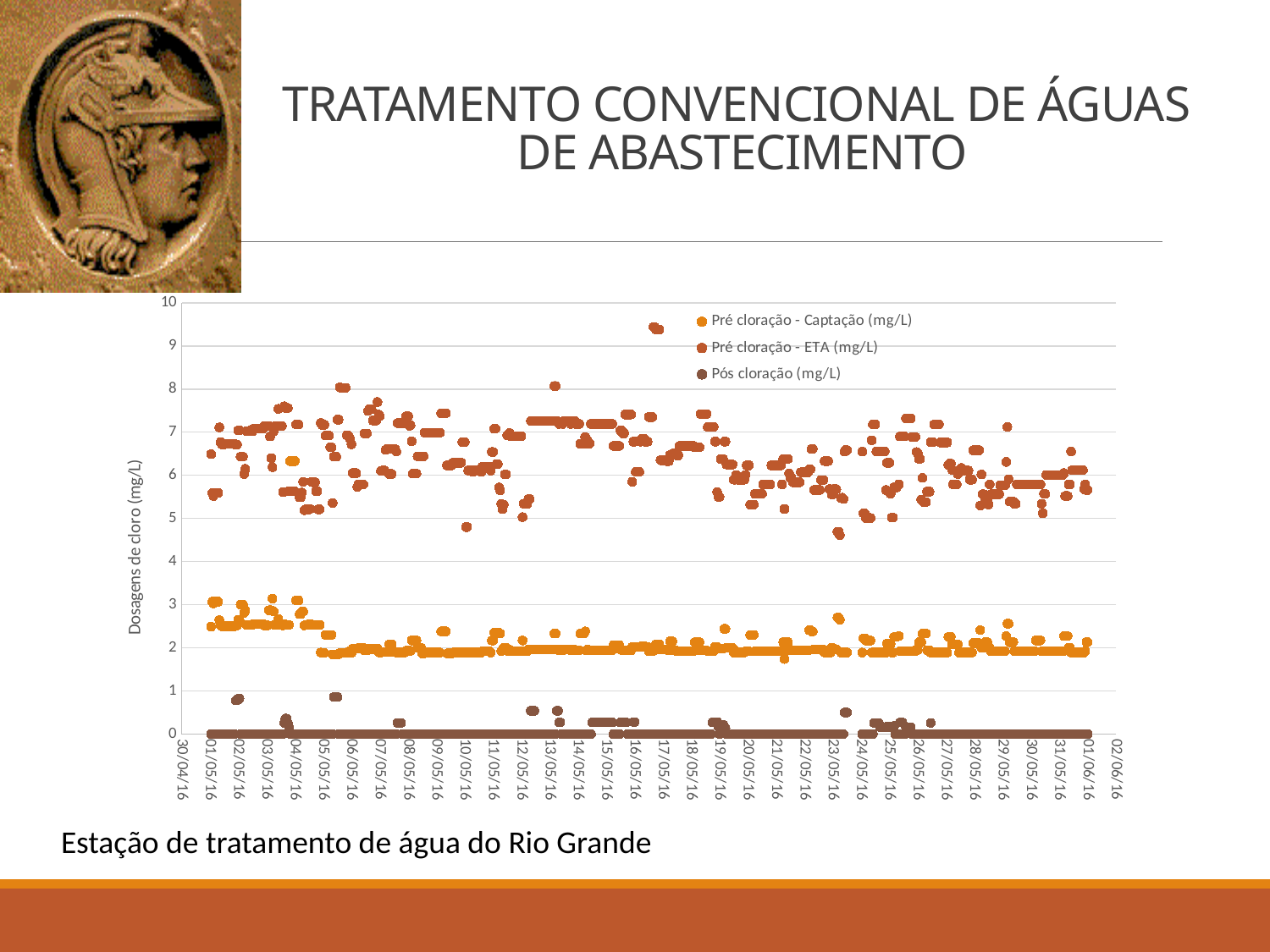
What is the title of the vertical axis of the chart? Dosagens de cloro (mg/L) How many series does the chart legend list? 3 Which series has the highest values overall in the chart? Pré cloração - ETA (mg/L) What kind of chart is shown on the slide? Scatter chart Are the Pré cloração - ETA (mg/L) values greater or less than 4 throughout the chart? greater Which series has the lowest values overall in the chart? Pós cloração (mg/L) Do the Pré cloração - Captação (mg/L) values rise or fall between 01/05/16 and 06/05/16? fall Which series is plotted in the darkest brown colour in the chart? Pós cloração (mg/L) Is the highest value of the Pré cloração - ETA (mg/L) series greater or less than 9? greater Are the values of the Pós cloração (mg/L) series greater or less than 1? less Which series has larger values: Pré cloração - ETA (mg/L) or Pré cloração - Captação (mg/L)? Pré cloração - ETA (mg/L)